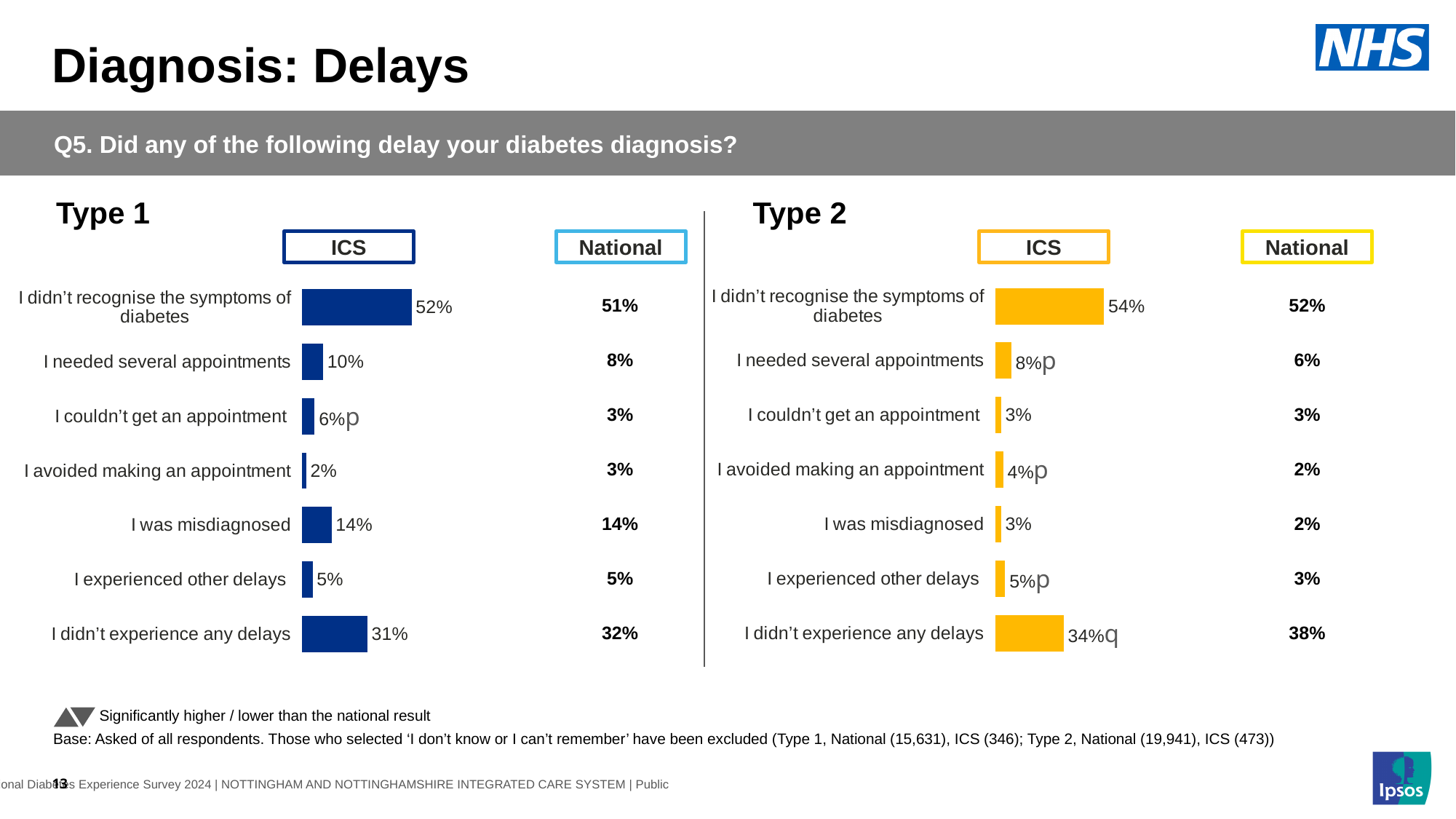
On the Type 1 chart, is the ICS value for 'I needed several appointments' larger or smaller than the National value? larger On the Type 1 chart, what is the ICS value for 'I didn't recognise the symptoms of diabetes'? 52% On the Type 2 chart, which category has the highest ICS value? I didn't recognise the symptoms of diabetes On the Type 1 chart, which category has the highest ICS value? I didn't recognise the symptoms of diabetes On the Type 1 chart, what is the National value for 'I was misdiagnosed'? 14% What colour are the ICS bars on the Type 2 chart? yellow On the Type 2 chart, what is the National value for 'I needed several appointments'? 6% On the Type 2 chart, what is the difference between the National and ICS values for 'I didn't experience any delays'? 4% On the Type 2 chart, what is the ICS value for 'I didn't experience any delays'? 34% On the Type 1 chart, how many categories are shown? 7 What kind of chart is used to show the ICS values on the Type 2 chart? bar chart On the Type 1 chart, which category has the lowest ICS value? I avoided making an appointment